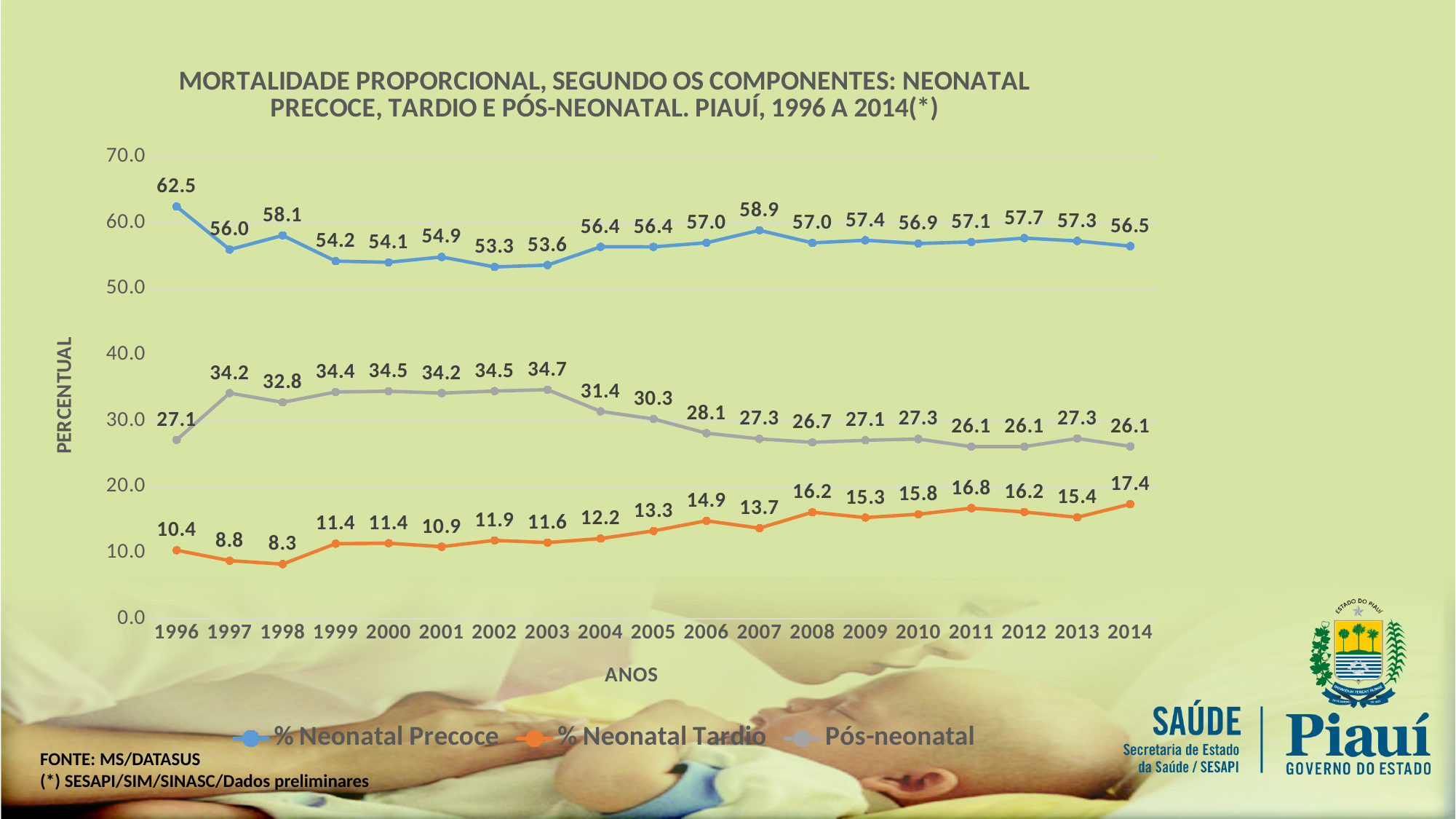
How many series does the legend list? 3 What is the value of Pós-neonatal in 2003? 34.7 What is the value of % Neonatal Tardio in 2014? 17.4 In which year is % Neonatal Tardio lowest? 1998 What is the value of % Neonatal Precoce in 1996? 62.5 In 1997, which is larger: Pós-neonatal or % Neonatal Tardio? Pós-neonatal What kind of chart is shown on the slide? Line chart In which year is % Neonatal Precoce highest? 1996 By how much did Pós-neonatal increase from 1996 to 1997? 7.1 What is the difference between % Neonatal Precoce in 1996 and in 2014? 6.0 In which year is Pós-neonatal highest? 2003 How many years are shown on the x axis? 19